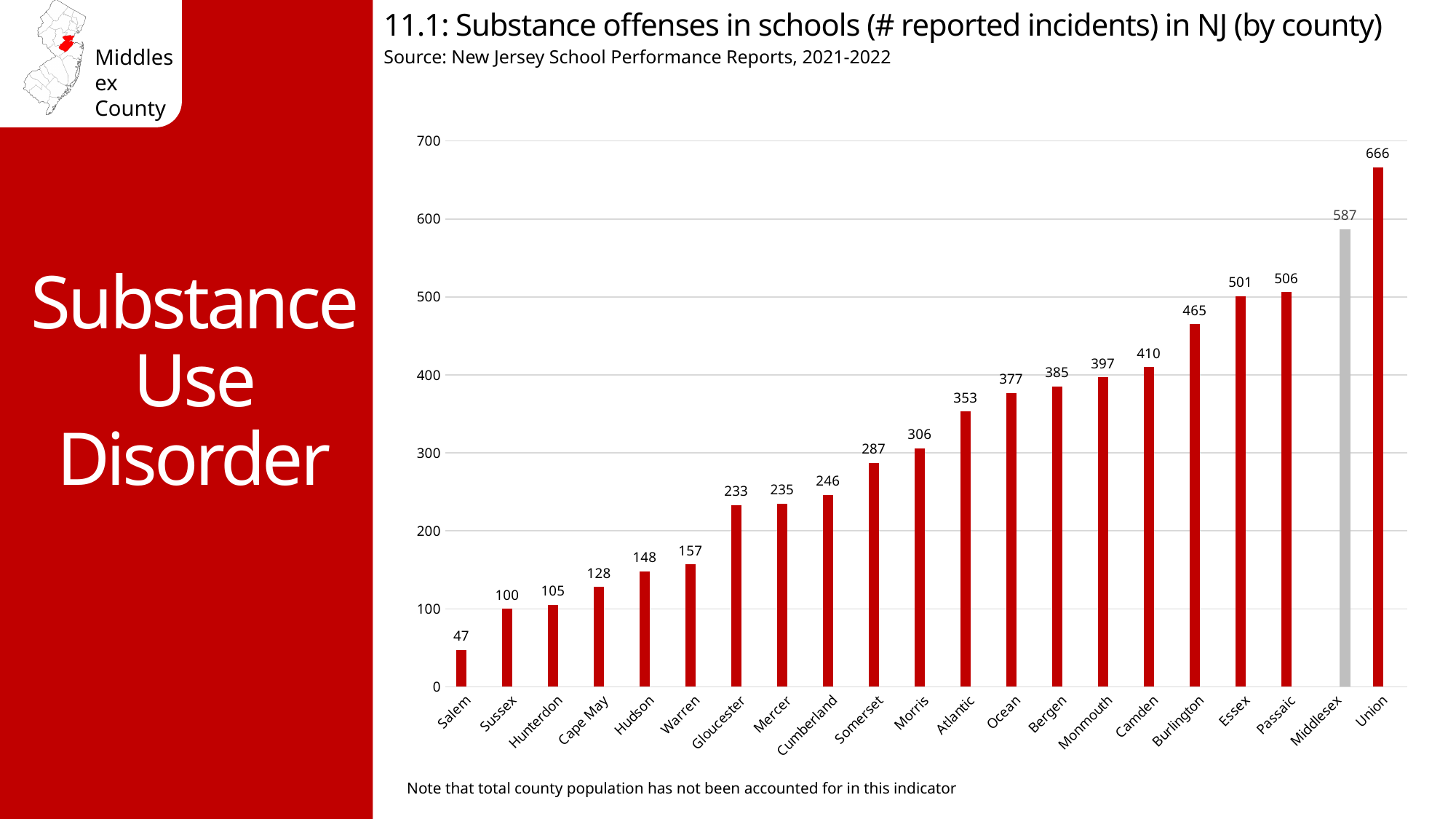
What kind of chart is shown on the slide? Bar chart Which county has the highest number of reported incidents? Union How many counties are shown on the chart? 21 Which county has the lowest number of reported incidents? Salem Which bar is shown in a different colour (gray) from the others? Middlesex Is the value for Burlington greater or less than 400? greater What is the difference between the values for Essex and Passaic? 5 What is the difference between the values for Union and Middlesex? 79 Which has a higher value, Bergen or Ocean? Bergen What is the value shown for Gloucester? 233 What is the number of reported substance offense incidents in schools for Middlesex County? 587 What is the value shown for Salem? 47